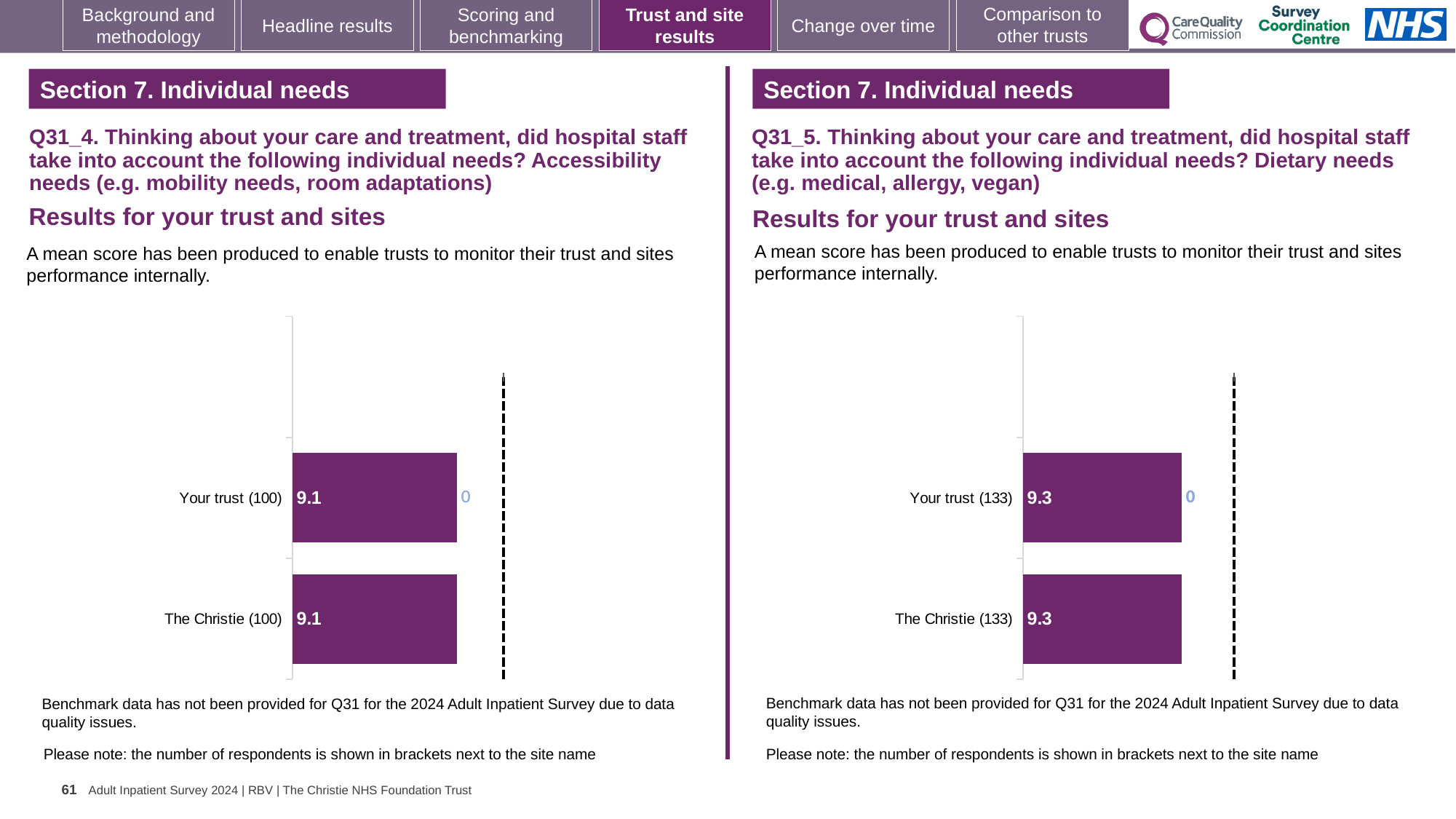
On the right chart (Q31_5, dietary needs), how many respondents are shown in brackets for The Christie? 133 On the right chart (Q31_5, dietary needs), how many bars are plotted? 2 On the left chart (Q31_4, accessibility needs), what is the mean score for The Christie? 9.1 On the right chart (Q31_5, dietary needs), what is the mean score for The Christie? 9.3 Which is larger: the Your trust score on the left chart (Q31_4) or the Your trust score on the right chart (Q31_5)? Right chart (Q31_5), 9.3 On the left chart (Q31_4, accessibility needs), what is the mean score for Your trust? 9.1 On the left chart (Q31_4, accessibility needs), how many bars are plotted? 2 On the left chart (Q31_4, accessibility needs), what is the difference between the scores for Your trust and The Christie? 0 What kind of chart is shown on the left (Q31_4, accessibility needs)? Bar chart On the right chart (Q31_5, dietary needs), what is the difference between the scores for Your trust and The Christie? 0 On the left chart (Q31_4, accessibility needs), how many respondents are shown in brackets for Your trust? 100 On the right chart (Q31_5, dietary needs), what is the mean score for Your trust? 9.3